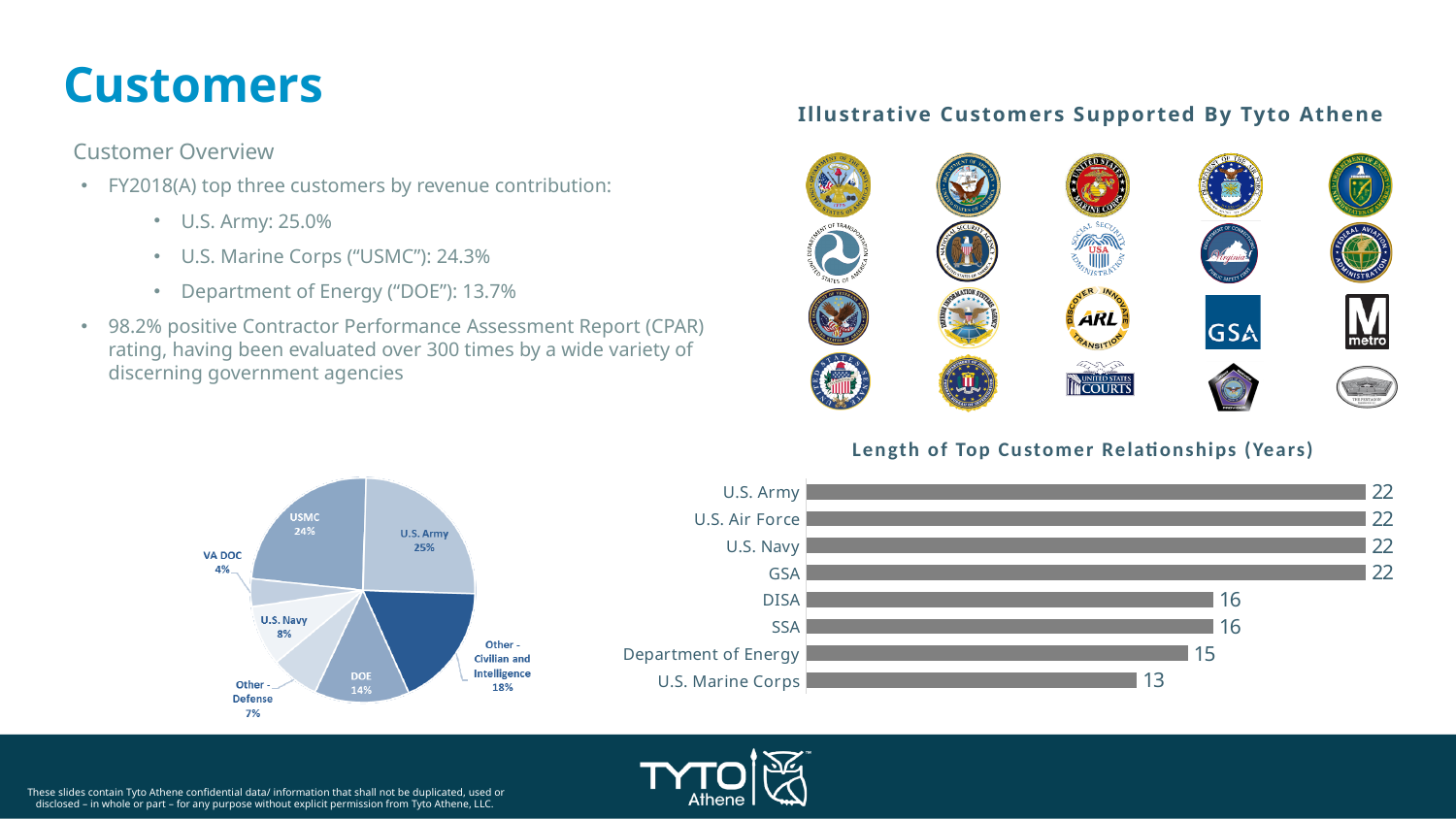
In the 'Length of Top Customer Relationships (Years)' chart, what is the value for U.S. Marine Corps? 13 In the pie chart at the bottom left of the slide, what share does DOE have? 14% In the pie chart at the bottom left of the slide, which slice is the smallest? VA DOC What kind of chart is the 'Length of Top Customer Relationships (Years)' chart? Bar chart In the 'Length of Top Customer Relationships (Years)' chart, which category has the lowest value? U.S. Marine Corps In the 'Length of Top Customer Relationships (Years)' chart, which is larger, the value for SSA or the value for Department of Energy? SSA In the 'Length of Top Customer Relationships (Years)' chart, what is the difference between the values for U.S. Army and U.S. Marine Corps? 9 In the 'Length of Top Customer Relationships (Years)' chart, what is the value for Department of Energy? 15 In the pie chart at the bottom left of the slide, what share does USMC have? 24% In the 'Length of Top Customer Relationships (Years)' chart, what is the value for DISA? 16 How many slices does the pie chart at the bottom left of the slide have? 7 How many categories are shown in the 'Length of Top Customer Relationships (Years)' chart? 8